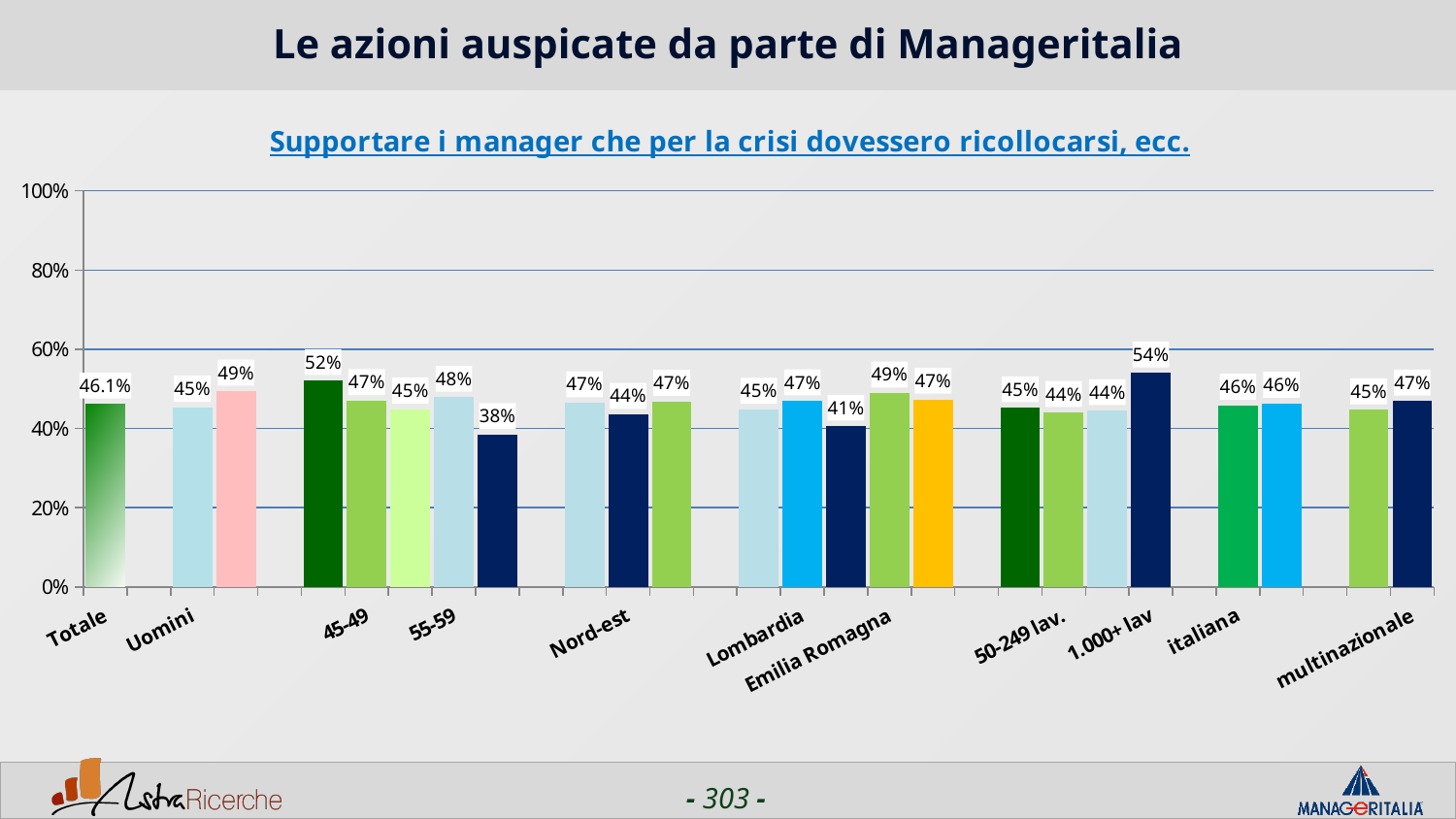
What is the lowest value shown on the chart? 38% Which category has the highest value? 1.000+ lav Is the value for 1.000+ lav greater or less than 60%? less What is the highest value shown on the chart? 54% How many bars are plotted on the chart? 24 What is the value for Uomini? 45% What is the value for 1.000+ lav? 54% What kind of chart is shown on the slide? bar chart What is the value for Totale? 46.1% Which is larger, the value for Totale or the value for Uomini? Totale What is the subtitle shown above the chart? Supportare i manager che per la crisi dovessero ricollocarsi, ecc. What is the difference between the value for 1.000+ lav and the value for Totale? 7.9 percentage points